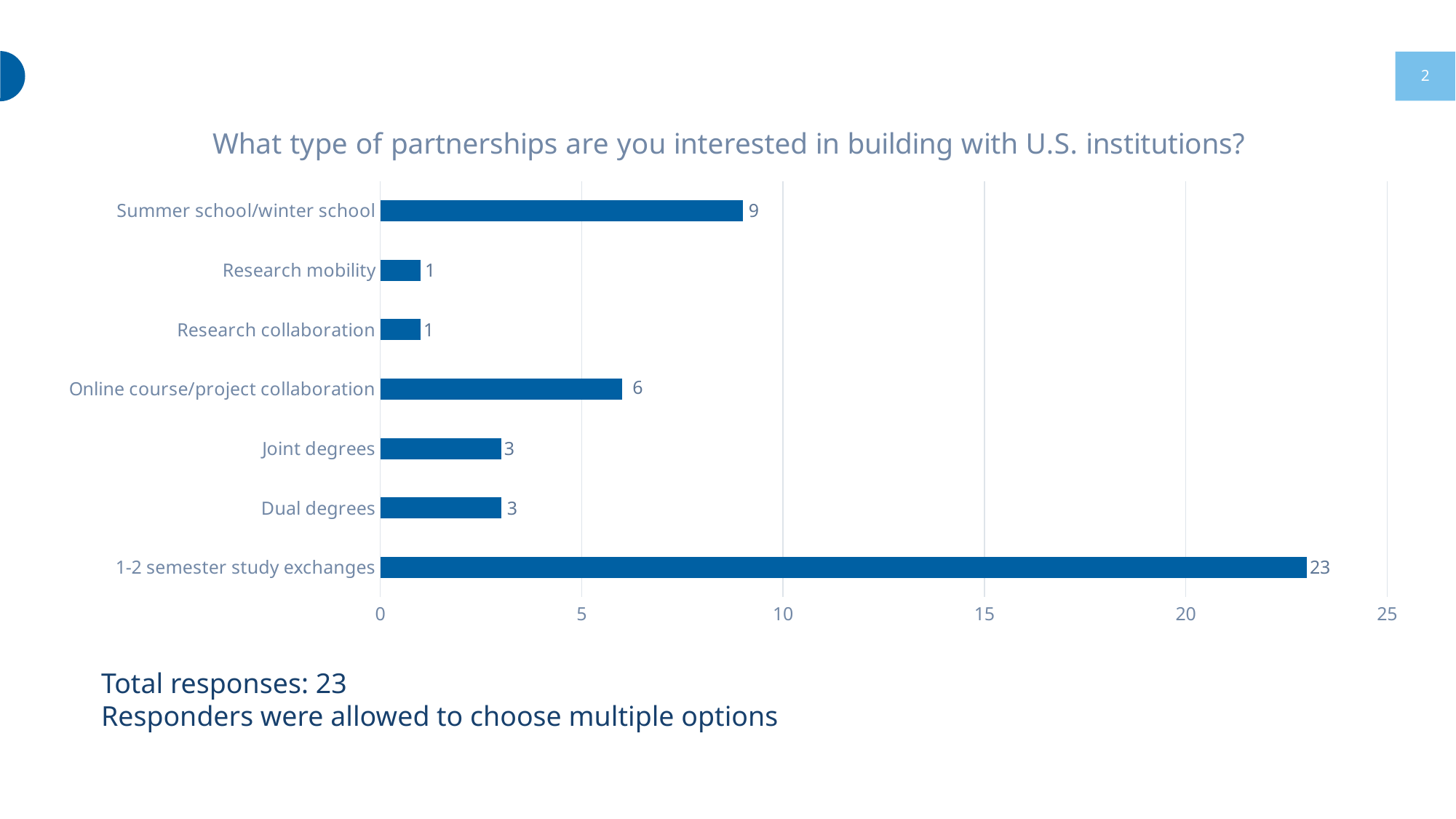
Is the value for 1-2 semester study exchanges greater or less than 20? greater What is the title of the chart? What type of partnerships are you interested in building with U.S. institutions? What is the value for Online course/project collaboration? 6 How many categories are shown in the chart? 7 What is the value for Summer school/winter school? 9 What is the value for Joint degrees? 3 Which is larger, the value for Online course/project collaboration or the value for Dual degrees? Online course/project collaboration What is the difference between the values for Summer school/winter school and Online course/project collaboration? 3 What kind of chart is shown on the slide? bar chart What is the difference between the values for 1-2 semester study exchanges and Summer school/winter school? 14 Which category has the highest value? 1-2 semester study exchanges What is the value for 1-2 semester study exchanges? 23